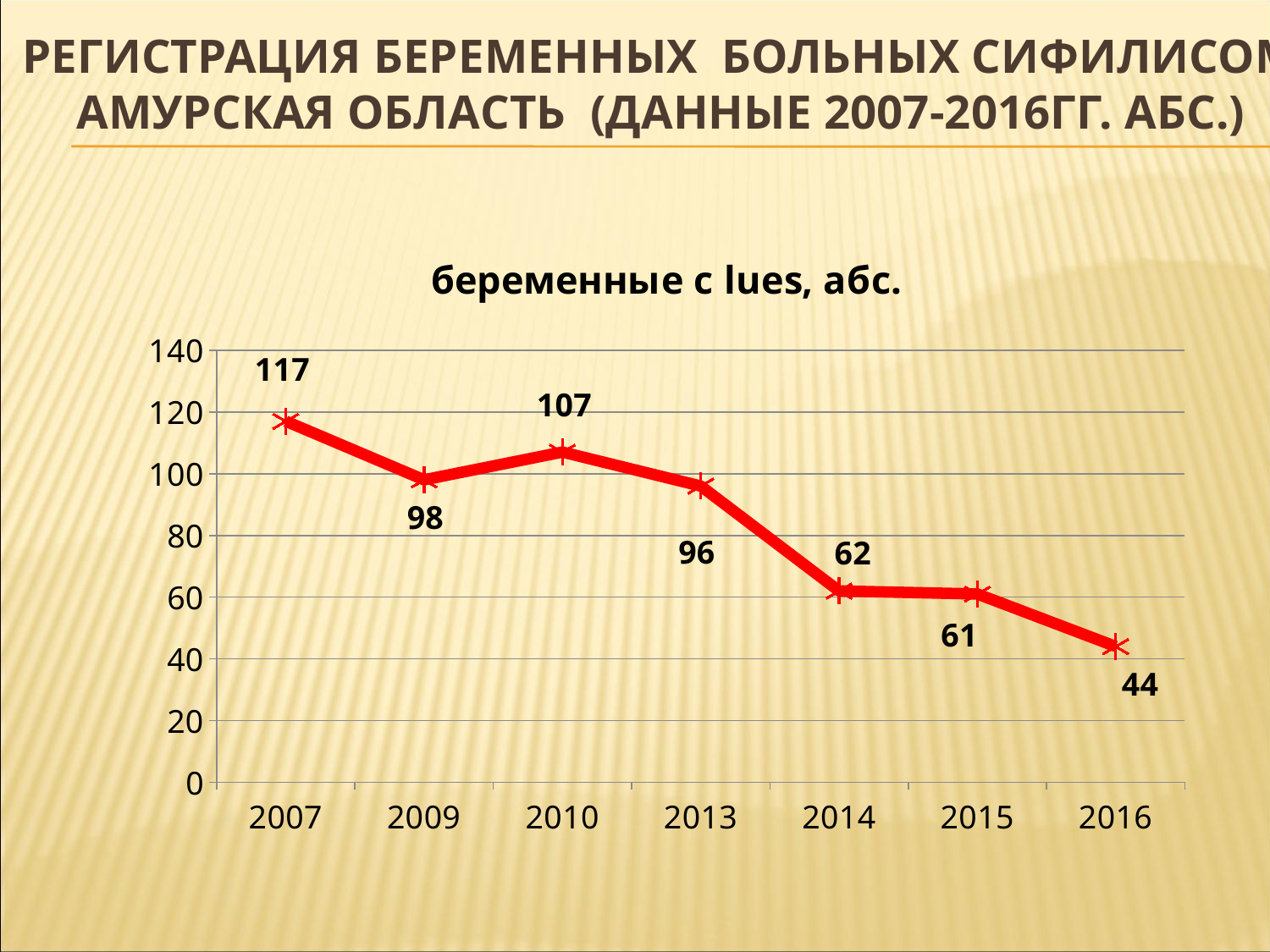
What is the title of the chart? беременные с lues, абс. What kind of chart is shown on the slide? line chart Which is larger, the value for 2009 or the value for 2010? 2010 Which year has the highest value? 2007 What is the value for 2016? 44 What is the value for 2007? 117 What is the value for 2010? 107 Do the values generally rise or fall from 2007 to 2016? fall What is the value for 2014? 62 Which year has the lowest value? 2016 How many data points are plotted on the chart? 7 What is the difference between the values for 2007 and 2016? 73